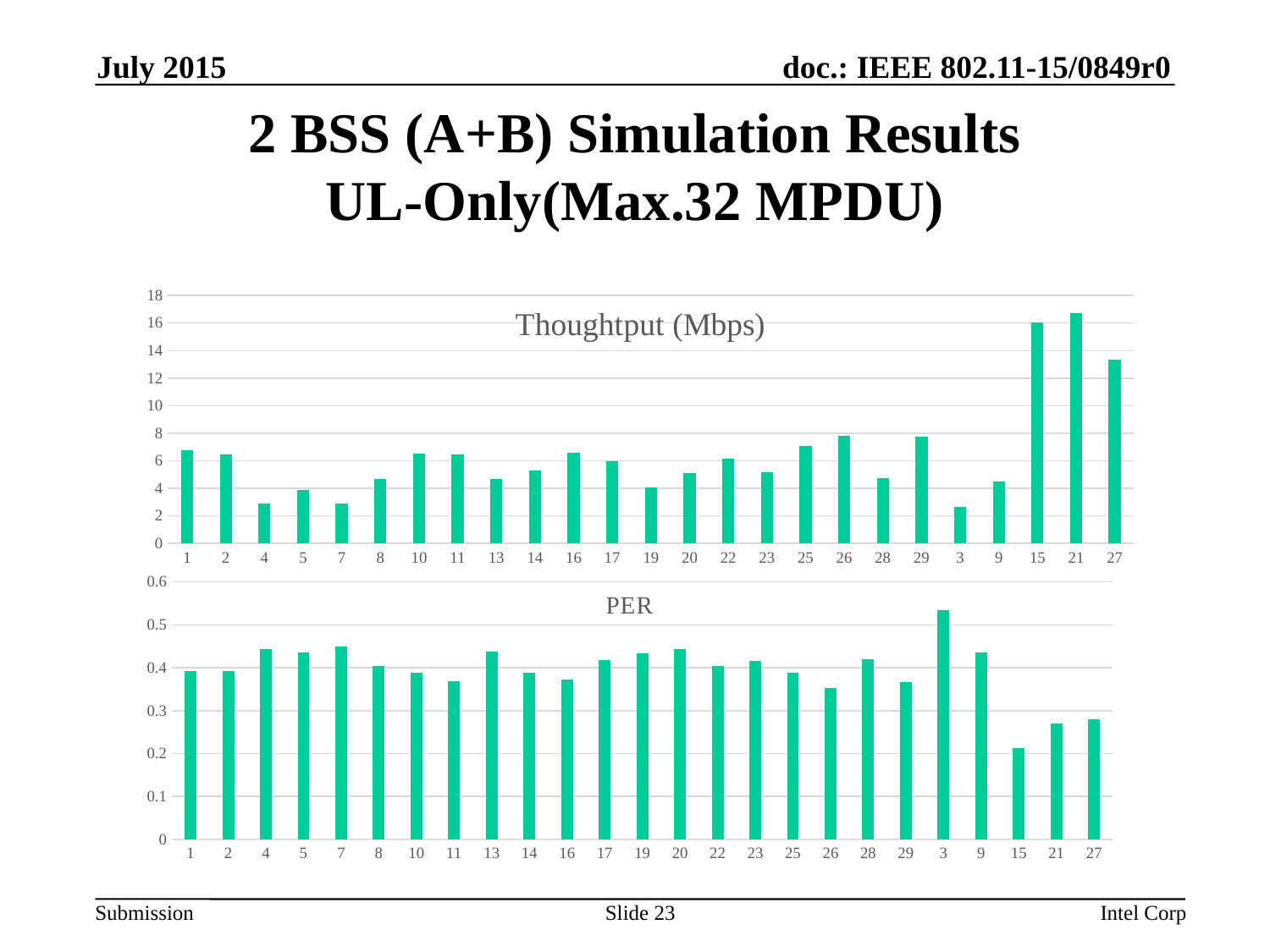
In the bottom chart "PER", is the value for category 3 greater or less than 0.5? greater In the top chart "Thoughtput (Mbps)", which category has the lowest value? 3 In the top chart "Thoughtput (Mbps)", which has the larger value, category 21 or category 27? 21 In the bottom chart "PER", which category has the lowest value? 15 In the bottom chart "PER", is the value for category 15 greater or less than 0.3? less In the top chart "Thoughtput (Mbps)", is the value for category 15 greater or less than 14? greater What kind of chart is the top chart titled "Thoughtput (Mbps)"? bar chart How many categories are plotted in the top chart "Thoughtput (Mbps)"? 25 What is the title of the bottom chart on the slide? PER In the top chart "Thoughtput (Mbps)", which category has the highest value? 21 In the bottom chart "PER", which category has the highest value? 3